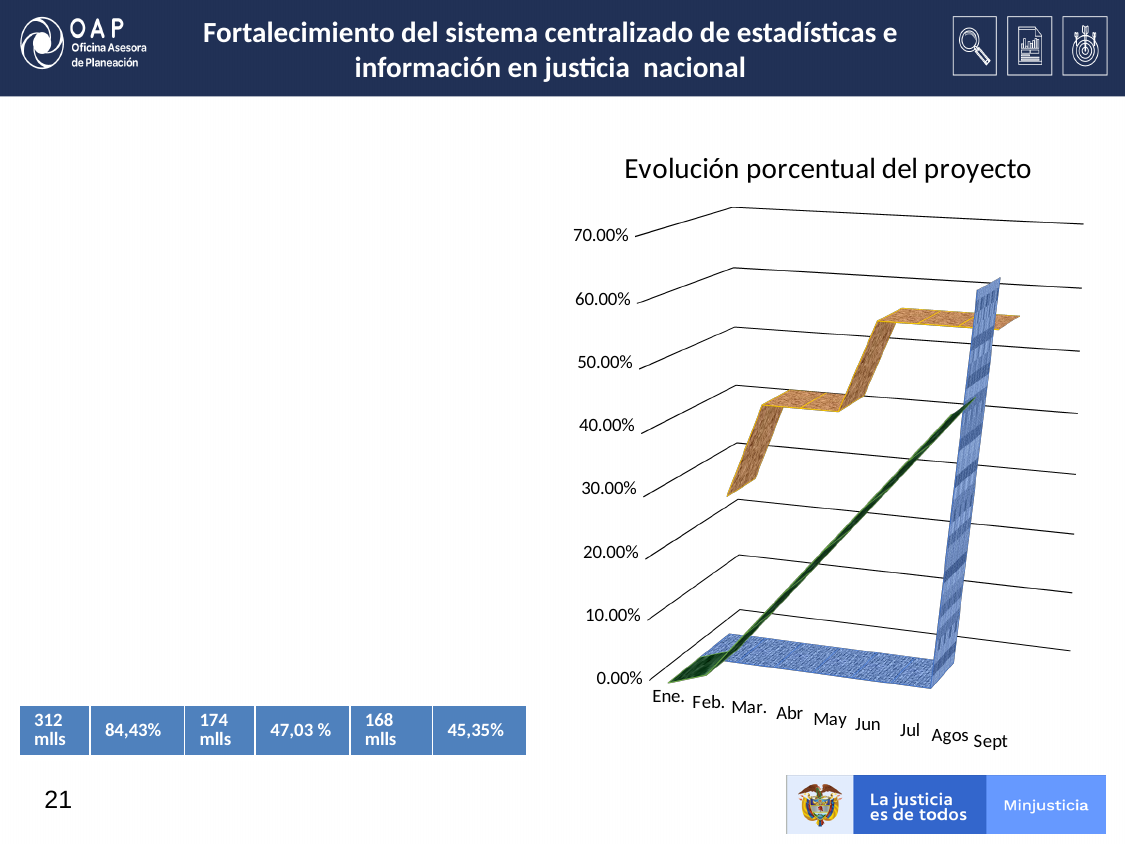
Which series is higher at Mar., the orange series or the blue series? orange What is the title of the chart on the slide? Evolución porcentual del proyecto Is the value of the green series at Ene. greater or less than 10.00%? less Does the green series rise or fall from Ene. to Sept? rise What is the first month label on the x axis of the chart? Ene. What kind of chart is shown on the slide? line chart What is the highest value shown on the vertical axis of the chart? 70.00% Is the value of the blue series at Feb. greater or less than 10.00%? less How many months are shown along the x axis of the chart? 9